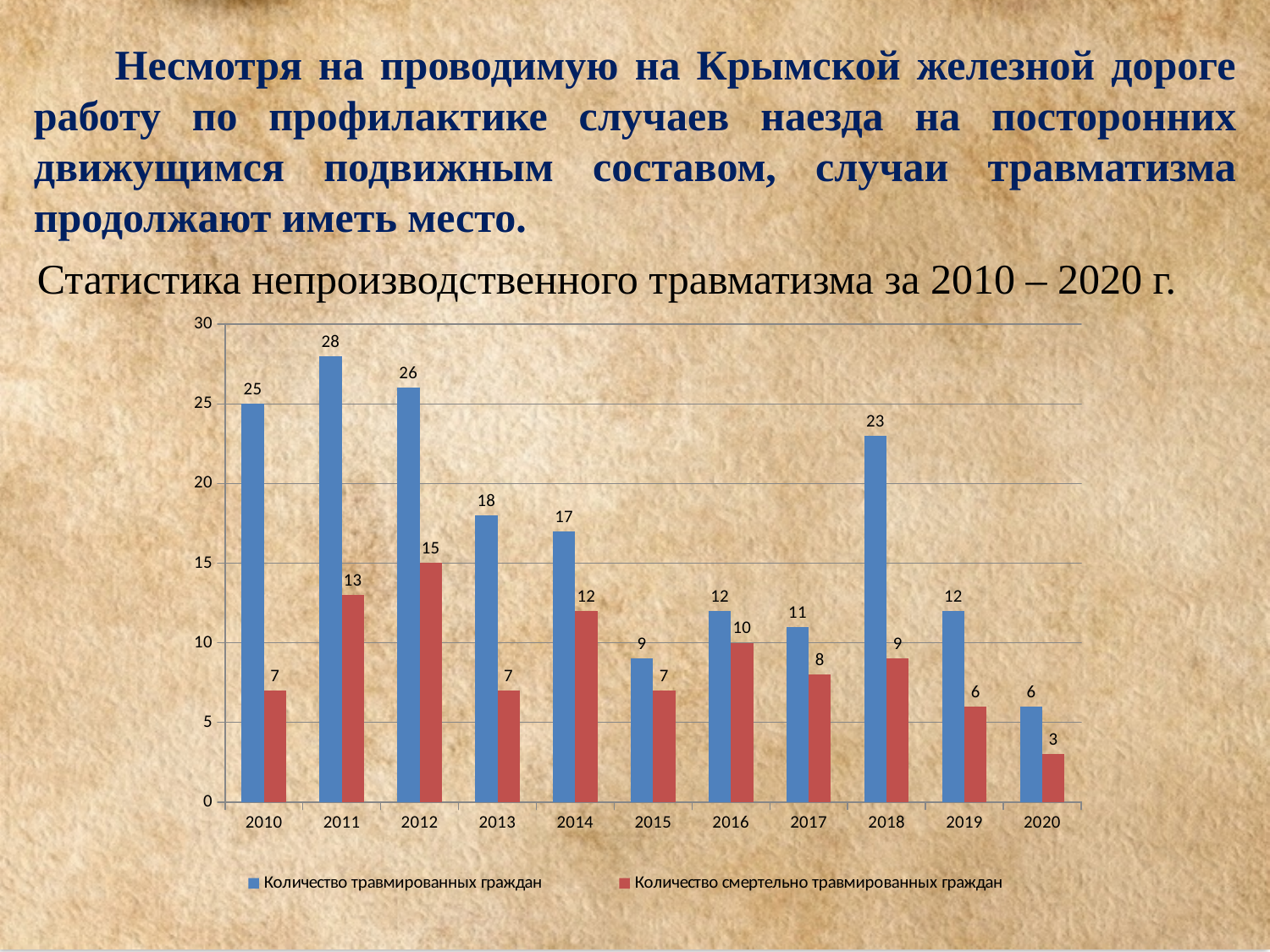
Which is larger: "Количество травмированных граждан" in 2016 or in 2017? 2016 What colour are the bars for "Количество смертельно травмированных граждан"? red What is the difference between "Количество травмированных граждан" and "Количество смертельно травмированных граждан" in 2010? 18 In which year is "Количество травмированных граждан" highest? 2011 In which year is "Количество смертельно травмированных граждан" lowest? 2020 What is the value for "Количество смертельно травмированных граждан" in 2012? 15 How many years are shown on the x axis of the chart? 11 What kind of chart is shown on the slide? bar chart What is the value for "Количество травмированных граждан" in 2018? 23 How many series does the legend list? 2 Does "Количество травмированных граждан" rise or fall from 2018 to 2020? fall What is the value for "Количество травмированных граждан" in 2011? 28